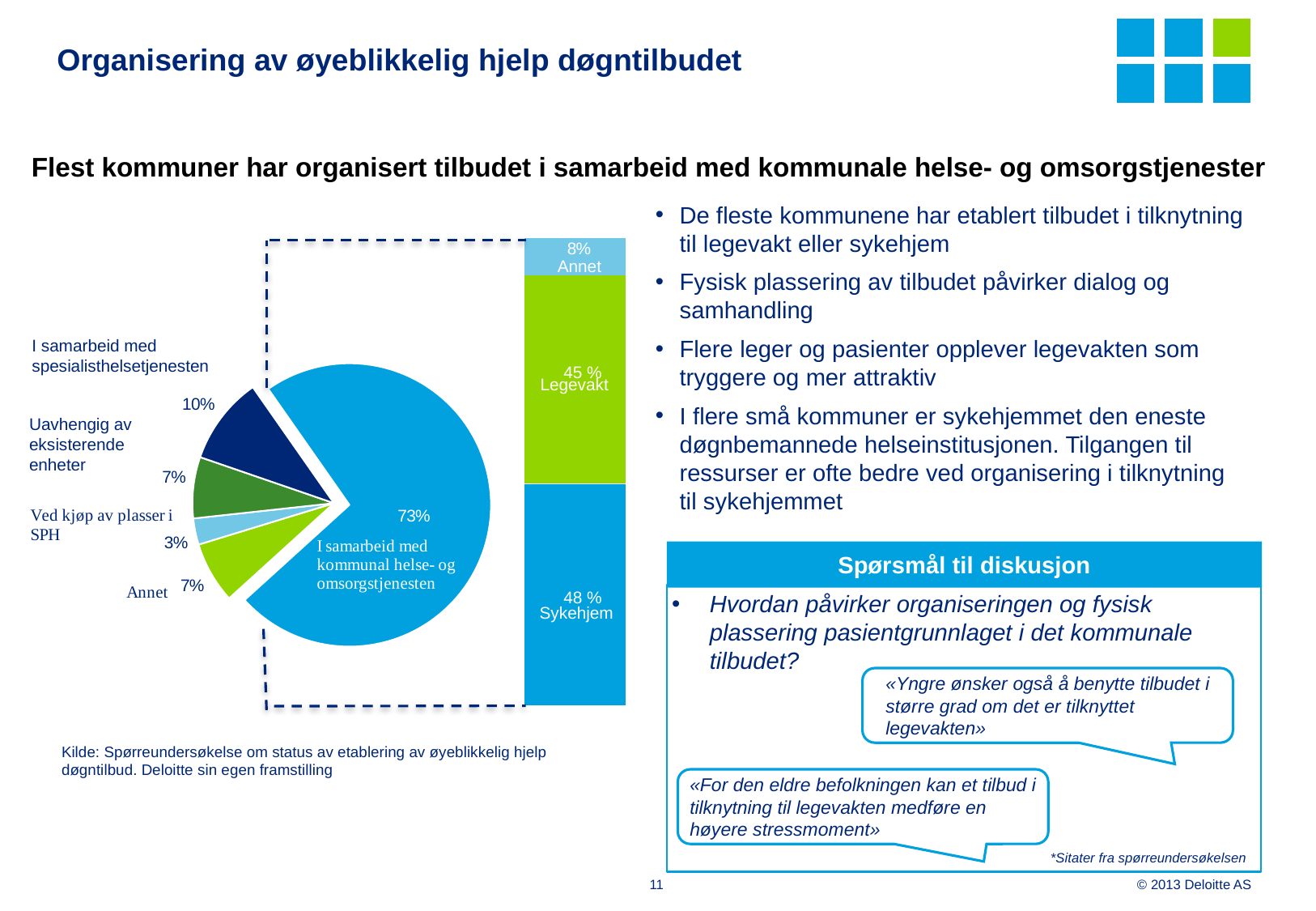
How many slices does the pie chart have? 5 In the stacked bar to the right of the pie, what is the value for 'Sykehjem'? 48 % In the pie chart, what share is labelled 'Uavhengig av eksisterende enheter'? 7% In the pie chart, what share is labelled 'I samarbeid med spesialisthelsetjenesten'? 10% In the pie chart, what is the difference between the share for 'I samarbeid med spesialisthelsetjenesten' and the share for 'Ved kjøp av plasser i SPH'? 7% In the stacked bar to the right of the pie, which segment is larger: 'Sykehjem' or 'Annet'? Sykehjem In the stacked bar to the right of the pie, what is the value for 'Legevakt'? 45 % In the pie chart, what share is labelled 'Ved kjøp av plasser i SPH'? 3% In the pie chart, which category has the smallest share? Ved kjøp av plasser i SPH In the pie chart, which category has the largest share? I samarbeid med kommunal helse- og omsorgstjenesten In the pie chart, what share is labelled 'I samarbeid med kommunal helse- og omsorgstjenesten'? 73% How many segments does the stacked bar to the right of the pie have? 3